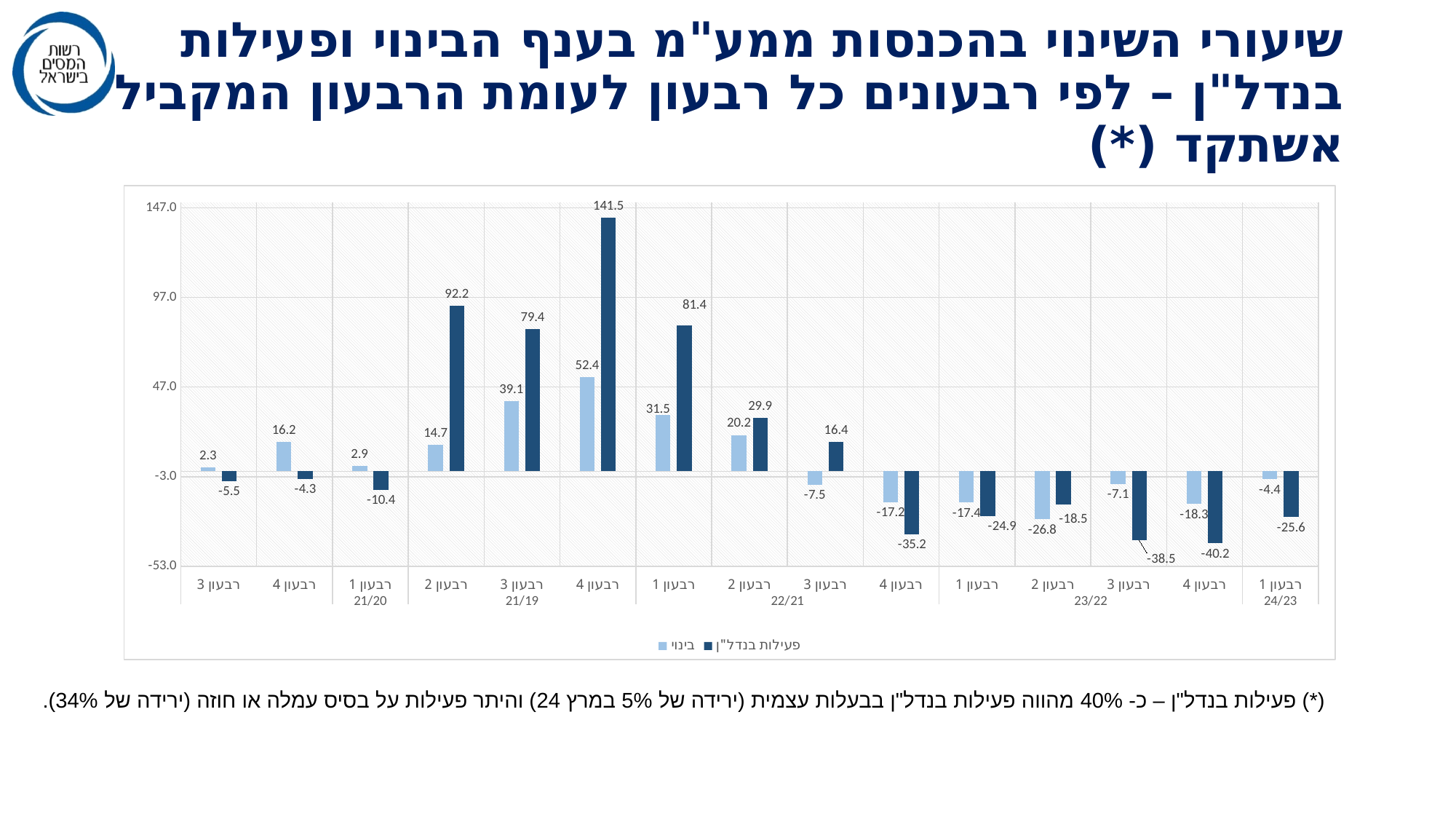
What is the value of בינוי for רבעון 1 24/23 (the last category on the right)? -4.4 What kind of chart is shown on the slide? bar chart What is the value of פעילות בנדל"ן for רבעון 3 23/22? -38.5 What is the highest value shown for the פעילות בנדל"ן series? 141.5 What is the lowest value shown for the בינוי series? -26.8 What is the highest value shown for the בינוי series? 52.4 How many series does the legend list? 2 For רבעון 1 21/20, which series has the larger value, בינוי or פעילות בנדל"ן? בינוי How many quarter categories are plotted along the x axis? 15 What is the value of פעילות בנדל"ן for רבעון 1 24/23 (the last category on the right)? -25.6 What is the lowest value shown for the פעילות בנדל"ן series? -40.2 For רבעון 1 24/23, what is the difference between the בינוי value and the פעילות בנדל"ן value? 21.2